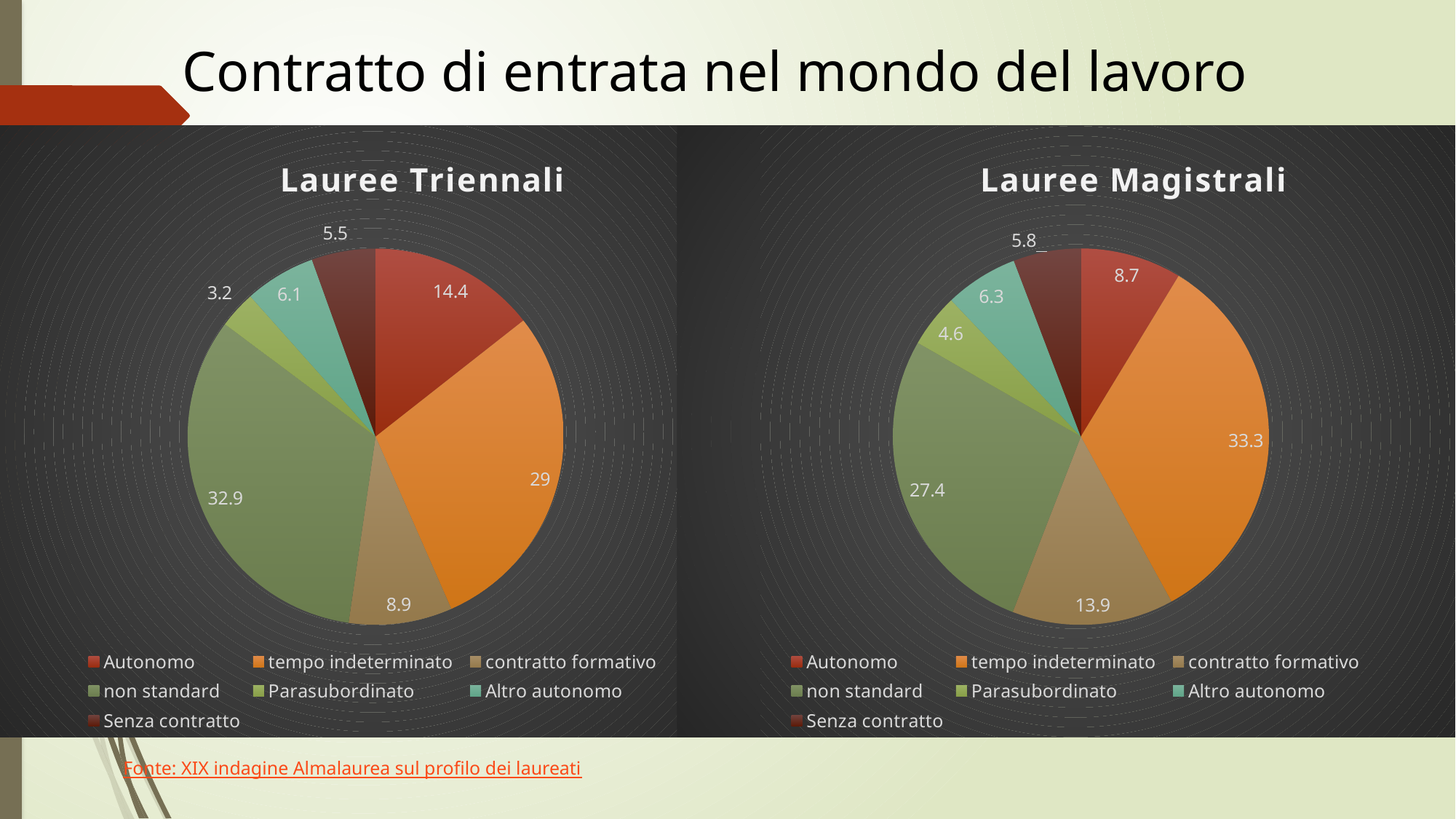
In the Lauree Triennali chart, what is the value for contratto formativo? 8.9 In the Lauree Magistrali chart, what is the value for tempo indeterminato? 33.3 In the Lauree Magistrali chart, what is the value for Parasubordinato? 4.6 How many slices does the Lauree Magistrali chart have? 7 In the Lauree Magistrali chart, which category has the smallest slice? Parasubordinato In the Lauree Triennali chart, which category has the largest slice? non standard In the Lauree Triennali chart, what is the value for non standard? 32.9 In the Lauree Magistrali chart, what is the difference between tempo indeterminato and non standard? 5.9 In the Lauree Triennali chart, which is larger: Autonomo or contratto formativo? Autonomo What kind of chart is the Lauree Triennali chart? pie chart In the Lauree Magistrali chart, what is the difference between Autonomo and Senza contratto? 2.9 In the Lauree Triennali chart, which category has the smallest slice? Parasubordinato